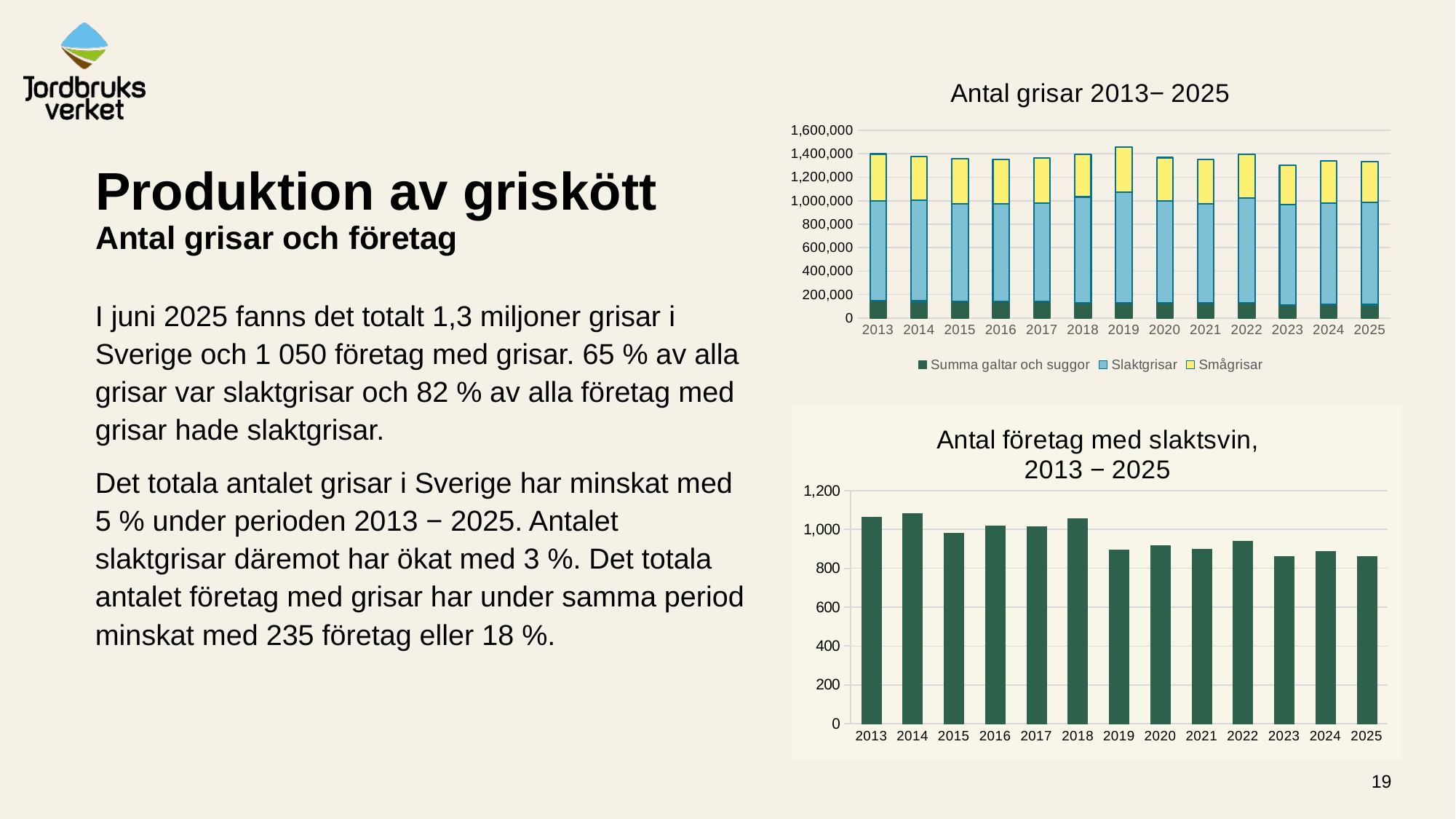
In the 'Antal grisar 2013− 2025' chart, is the total for 2023 greater or less than 1,400,000? less In the 'Antal grisar 2013− 2025' chart, which series is shown in yellow? Smågrisar In the 'Antal grisar 2013− 2025' chart, is the total for 2019 greater or less than 1,400,000? greater In the 'Antal företag med slaktsvin, 2013 − 2025' chart, is the value for 2019 greater or less than 1,000? less In the 'Antal företag med slaktsvin, 2013 − 2025' chart, do the values generally rise or fall from 2013 to 2025? fall What kind of chart is the 'Antal grisar 2013− 2025' chart? stacked bar chart How many series does the legend of the 'Antal grisar 2013− 2025' chart list? 3 What kind of chart is the 'Antal företag med slaktsvin, 2013 − 2025' chart? bar chart In the 'Antal grisar 2013− 2025' chart, which year has the highest total number of pigs? 2019 How many years are shown on the x axis of the 'Antal företag med slaktsvin, 2013 − 2025' chart? 13